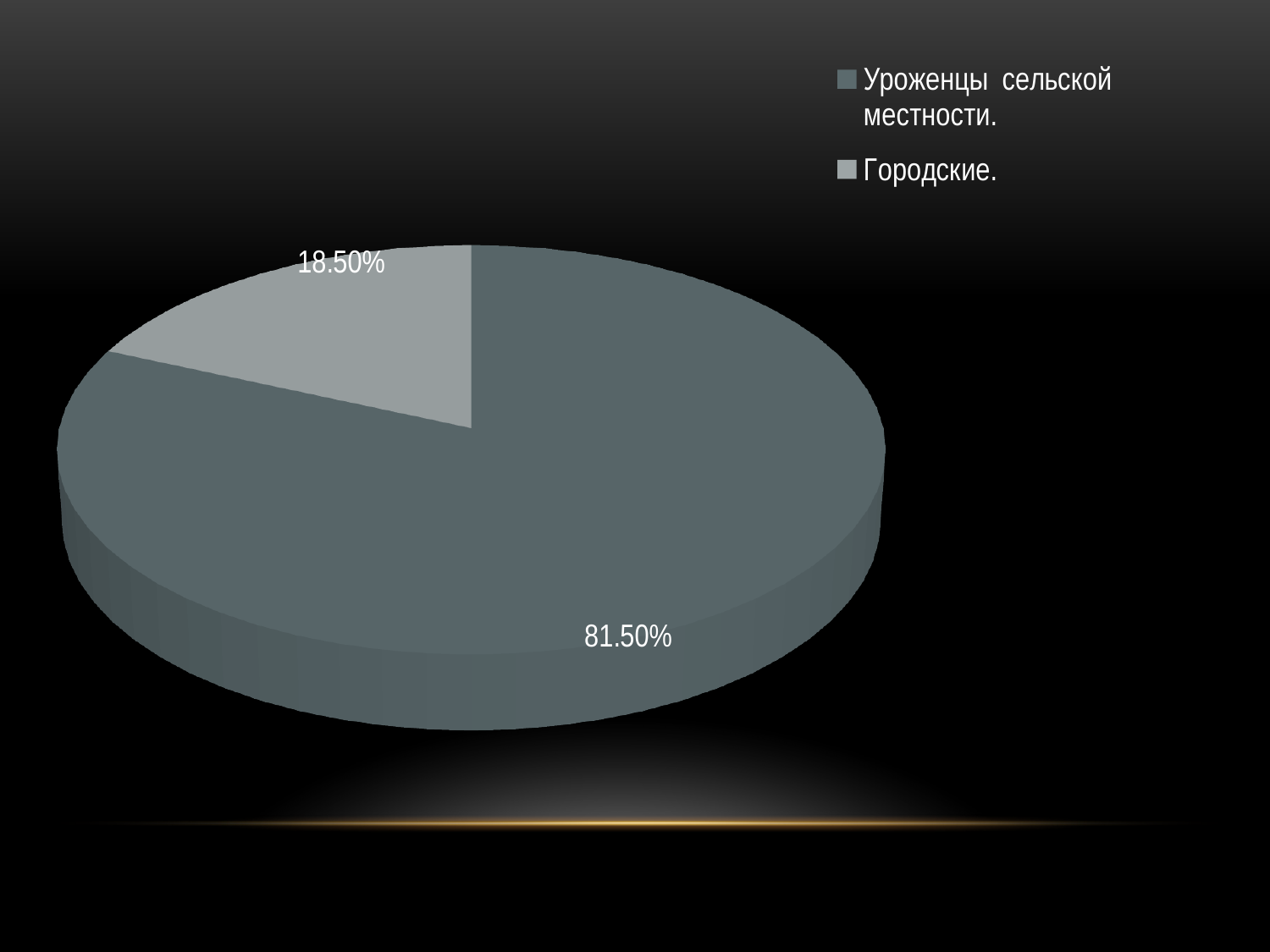
What is the value for Городские? 18.50% What is the value for Уроженцы сельской местности? 81.50% Which category has the largest slice? Уроженцы сельской местности. Where is the legend positioned on the slide? top right What kind of chart is shown on the slide? pie chart Which is larger, the slice for Уроженцы сельской местности or the slice for Городские? Уроженцы сельской местности. What share of the pie does the Городские slice represent? 18.50% Which legend entry is listed first? Уроженцы сельской местности. How many entries does the legend list? 2 How many slices does the pie chart have? 2 What is the difference between the values for Уроженцы сельской местности and Городские? 63.00% Which category has the smallest slice? Городские.